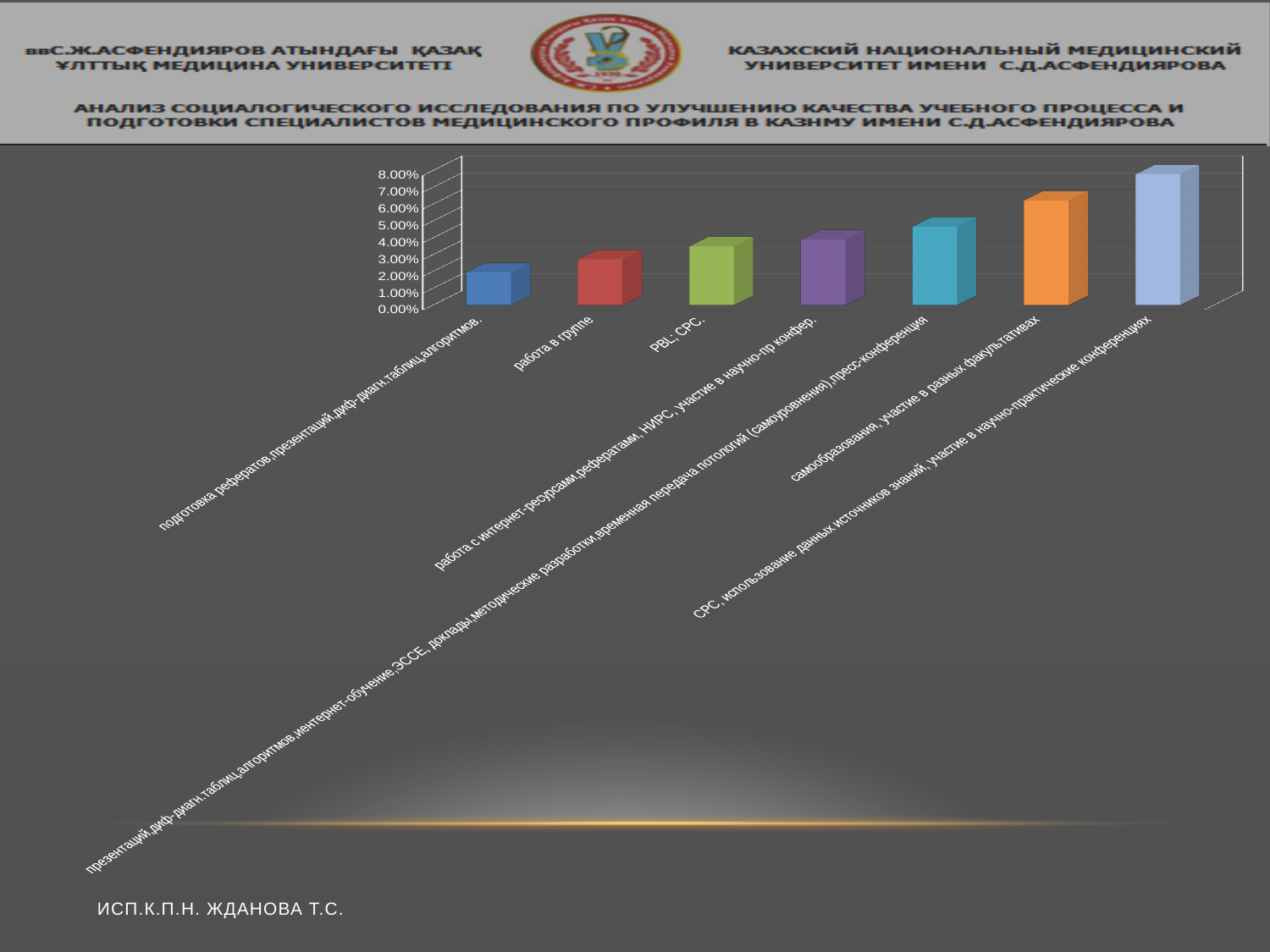
Do the bar values rise or fall from left to right along the x axis? rise Is the value for "PBL, СРС." greater or less than 6.00%? less Which is larger: the value for "работа в группе" or the value for "PBL, СРС."? PBL, СРС. Which category has the lowest bar? подготовка рефератов,презентаций,диф-диагн,таблиц,алгоритмов. What kind of chart is shown on the slide? bar chart Is the value for "самообразования, участие в разных факультативах" greater or less than 5.00%? greater How many bars (categories) does the chart show? 7 Is the value for "подготовка рефератов,презентаций,диф-диагн,таблиц,алгоритмов." greater or less than 4.00%? less What is the highest value shown on the chart's vertical axis? 8.00% Which category has the highest bar? СРС, использование данных источников знаний, участие в научно-практические конференциях Which is larger: the value for "самообразования, участие в разных факультативах" or the value for "работа в группе"? самообразования, участие в разных факультативах